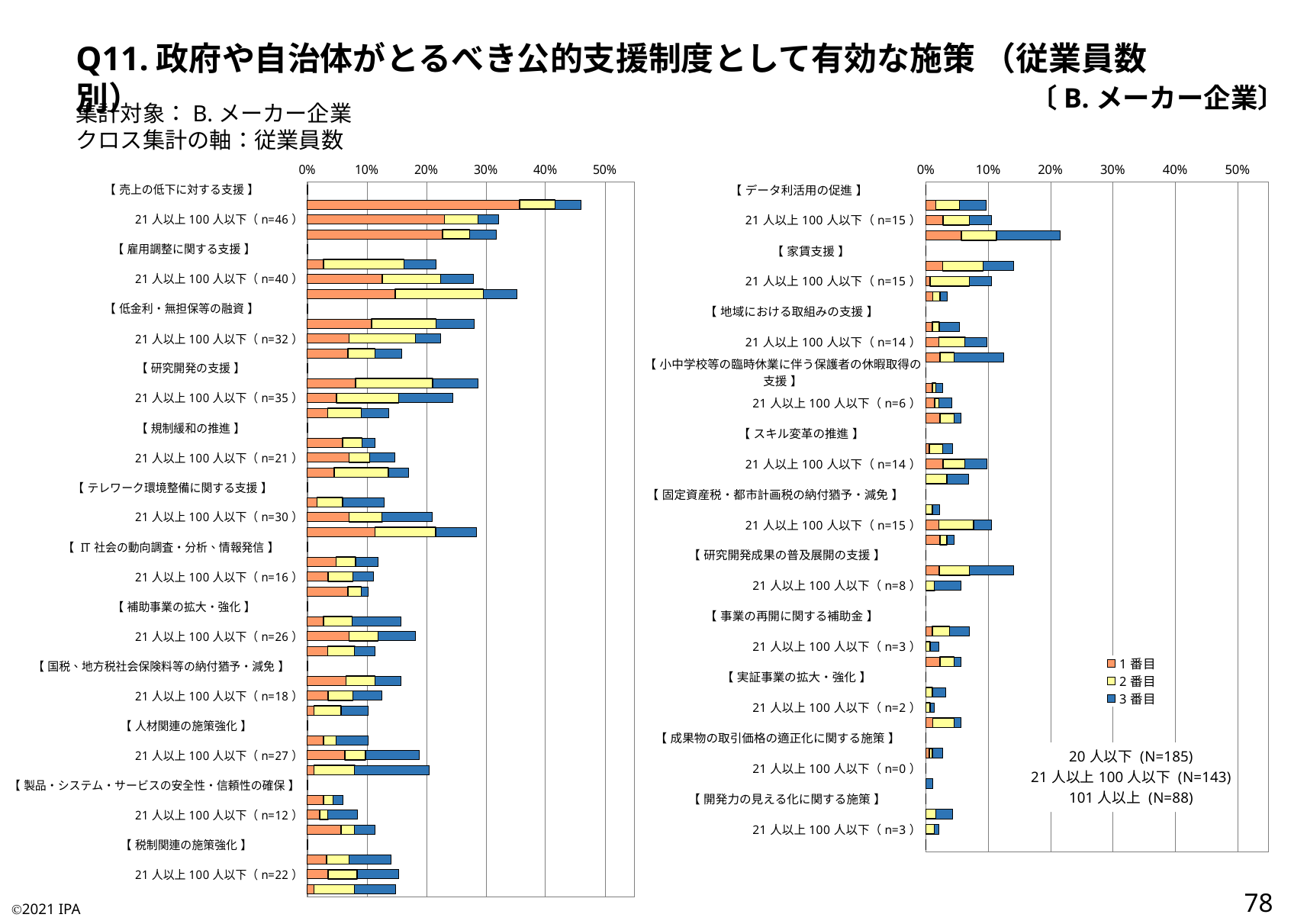
In the left chart, which has the larger total stacked bar: 21人以上100人以下 (n=40) under 雇用調整に関する支援 or 21人以上100人以下 (n=12) under 製品・システム・サービスの安全性・信頼性の確保? 21人以上100人以下 (n=40) under 雇用調整に関する支援 In the left chart, is the total stacked value for 21人以上100人以下 (n=40) under 雇用調整に関する支援 greater or less than 30%? less In the left chart, what is the n value shown for 21人以上100人以下 under 研究開発の支援? n=35 In the right chart, which category group contains the longest stacked bar? データ利活用の促進 How many series does the legend on the right chart list? 3 In the right chart, is the total stacked value for 21人以上100人以下 (n=8) under 研究開発成果の普及展開の支援 greater or less than 10%? less What are the three legend entries shown on the right chart? 1番目, 2番目, 3番目 In the right chart, is the total stacked value for 21人以上100人以下 (n=3) under 事業の再開に関する補助金 greater or less than 10%? less In the left chart, which category group contains the longest stacked bar? 売上の低下に対する支援 What kind of chart is shown on the left side of the slide? stacked bar chart In the left chart, which has the larger total stacked bar: 21人以上100人以下 (n=46) under 売上の低下に対する支援 or 21人以上100人以下 (n=21) under 規制緩和の推進? 21人以上100人以下 (n=46) under 売上の低下に対する支援